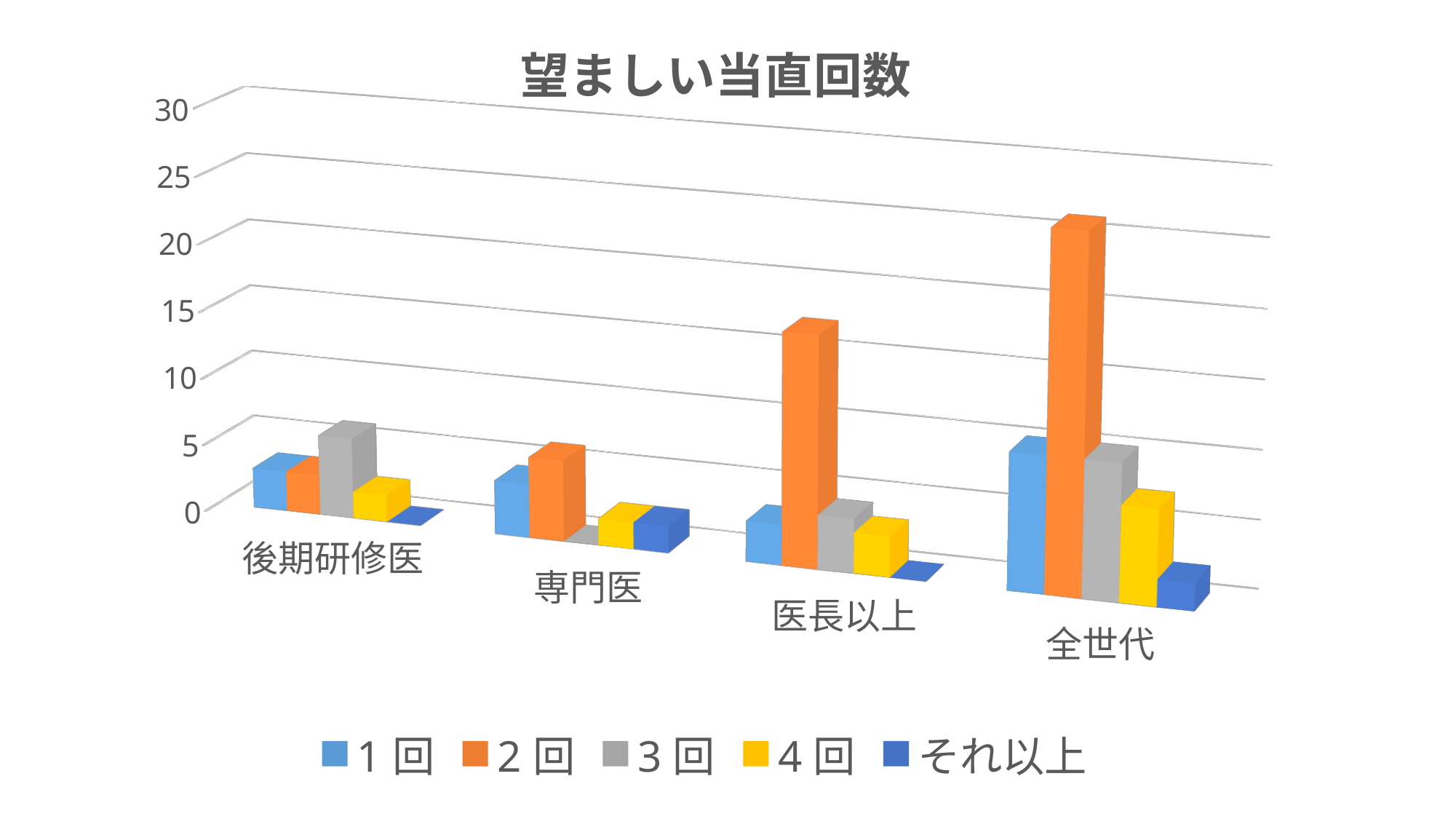
Which series has the highest value in the 医長以上 category? 2回 Which series has the highest value in the 全世代 category? 2回 What is the title of the chart? 望ましい当直回数 Which series has the highest value in the 後期研修医 category? 3回 Is the value for 2回 in the 医長以上 category greater or less than 10? greater Which series is listed last in the legend? それ以上 How many categories are shown on the x axis? 4 How many series does the legend list? 5 Which is larger: the 2回 value for 医長以上 or the 2回 value for 専門医? 医長以上 What kind of chart is shown on the slide? bar chart Is the value for 2回 in the 全世代 category greater or less than 20? greater